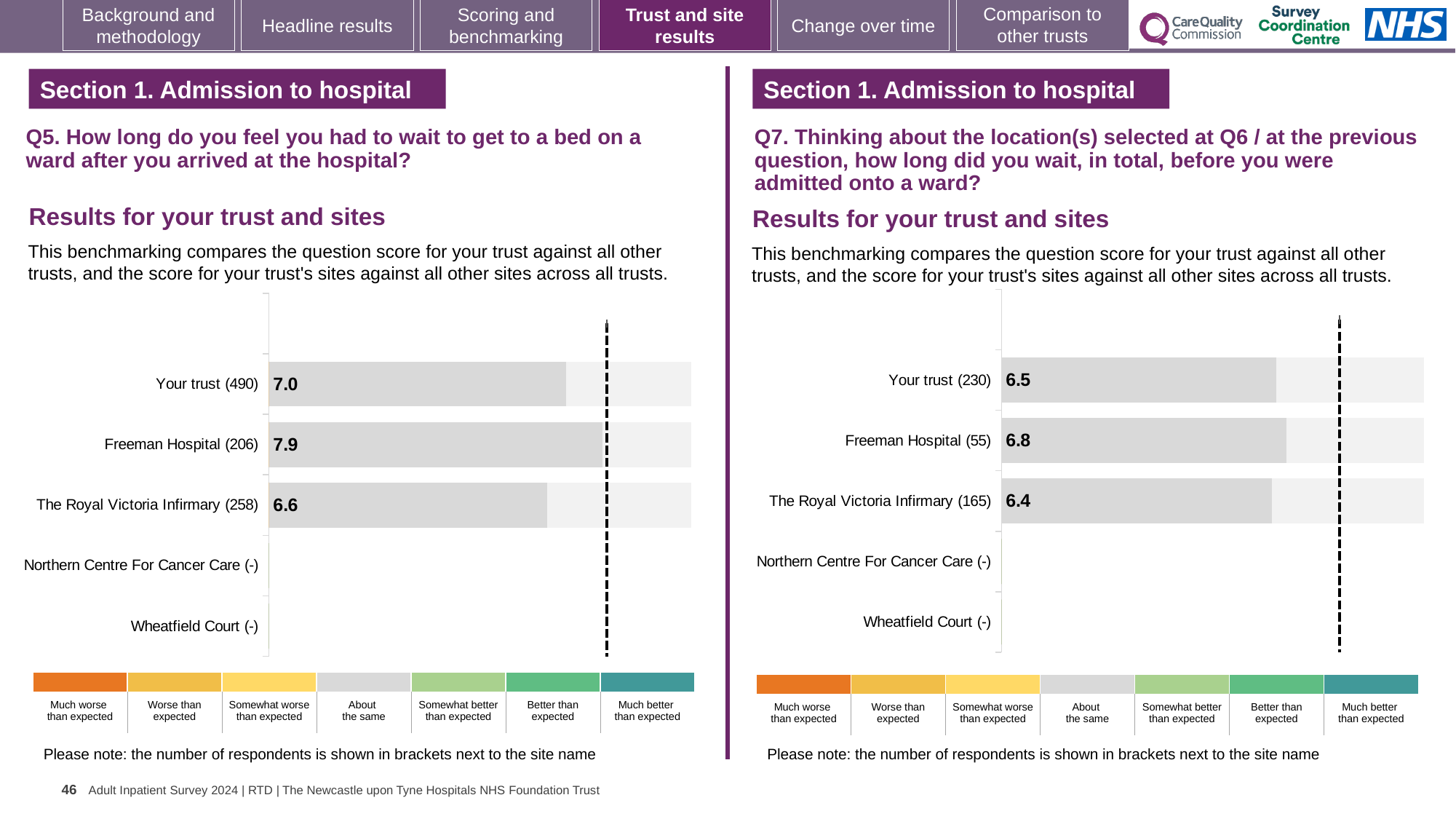
What kind of chart is used on the Q5 chart (left)? Bar chart On the Q5 chart (left), what is the score for Your trust? 7.0 On the Q7 chart (right), what is the score for Freeman Hospital? 6.8 On the Q7 chart (right), what is the score for Your trust? 6.5 On the Q7 chart (right), which is larger: the score for Freeman Hospital or the score for The Royal Victoria Infirmary? Freeman Hospital On the Q5 chart (left), what is the score for Freeman Hospital? 7.9 On the Q5 chart (left), what is the difference between the Freeman Hospital score and The Royal Victoria Infirmary score? 1.3 On the Q5 chart (left), which site has the highest score? Freeman Hospital On the Q5 chart (left), what is the score for The Royal Victoria Infirmary? 6.6 On the Q7 chart (right), how many respondents are shown for The Royal Victoria Infirmary? 165 On the Q5 chart (left), how many respondents are shown for Your trust? 490 On the Q7 chart (right), which site has the lowest score among those with a value shown? The Royal Victoria Infirmary